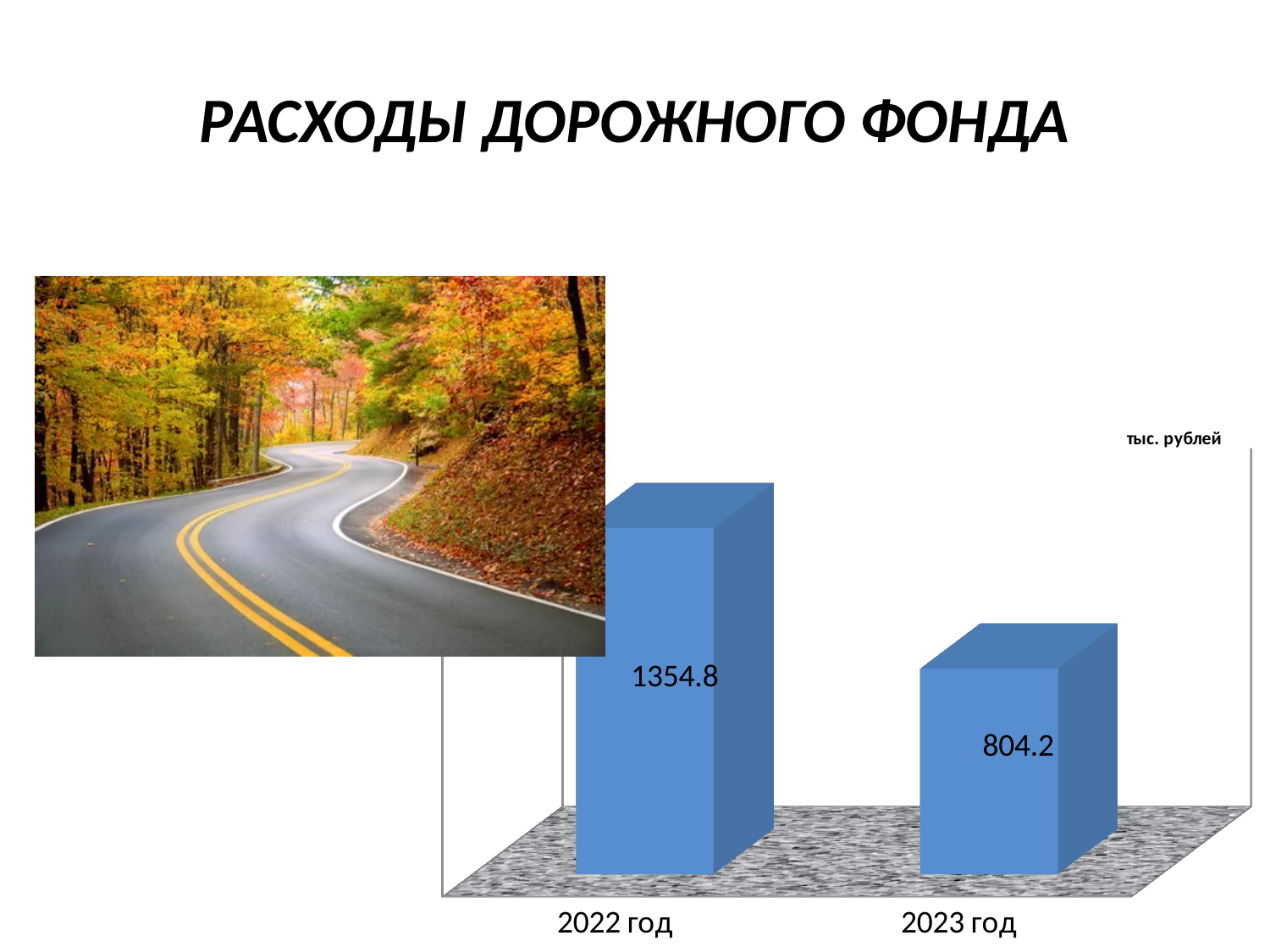
What is the difference between the values for 2022 год and 2023 год? 550.6 Do the values rise or fall from 2022 год to 2023 год? fall Which year has the highest value? 2022 год What is the value for 2022 год? 1354.8 Which year has the lowest value? 2023 год What is the value for 2023 год? 804.2 What kind of chart is shown on the slide? bar chart What is the title of the slide? РАСХОДЫ ДОРОЖНОГО ФОНДА How many categories are shown in the chart? 2 Which is larger, the value for 2022 год or for 2023 год? 2022 год What unit is indicated on the chart? тыс. рублей